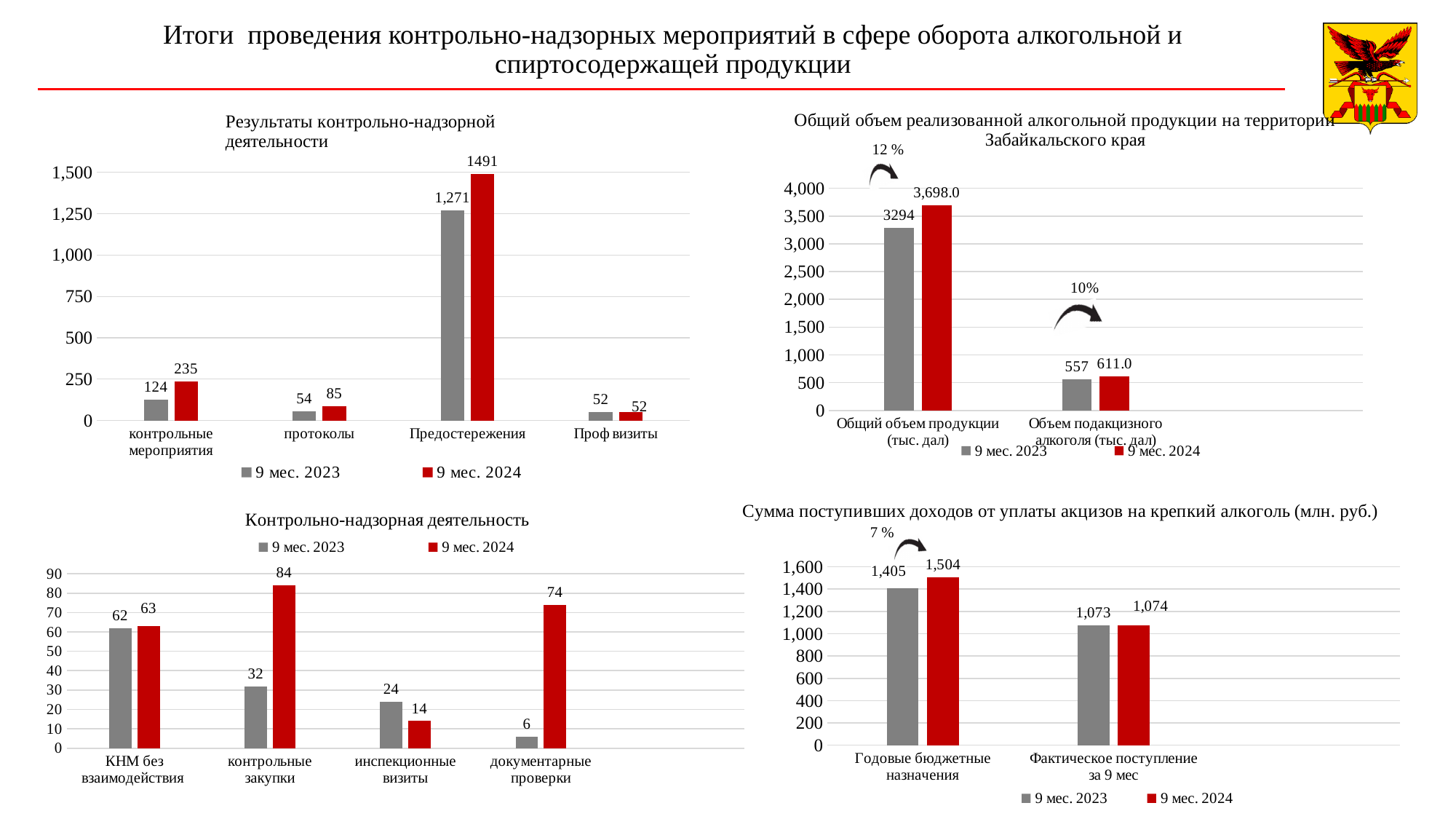
In the chart 'Сумма поступивших доходов от уплаты акцизов на крепкий алкоголь (млн. руб.)', what is the 9 мес. 2024 value for Годовые бюджетные назначения? 1,504 In the chart 'Контрольно-надзорная деятельность', what is the 9 мес. 2024 value for документарные проверки? 74 In the chart 'Контрольно-надзорная деятельность', which category has the lowest value in the 9 мес. 2023 series? документарные проверки In the chart 'Результаты контрольно-надзорной деятельности', what is the value for Предостережения in the 9 мес. 2024 series? 1491 What type of chart is 'Сумма поступивших доходов от уплаты акцизов на крепкий алкоголь (млн. руб.)'? Bar chart In the chart 'Общий объем реализованной алкогольной продукции на территории Забайкальского края', what is the 9 мес. 2024 value for Общий объем продукции (тыс. дал)? 3,698.0 In the chart 'Результаты контрольно-надзорной деятельности', what is the difference between the 9 мес. 2024 and 9 мес. 2023 values for контрольные мероприятия? 111 In the chart 'Общий объем реализованной алкогольной продукции на территории Забайкальского края', how many series does the legend list? 2 In the chart 'Результаты контрольно-надзорной деятельности', how many categories are shown on the x axis? 4 In the chart 'Общий объем реализованной алкогольной продукции на территории Забайкальского края', what is the 9 мес. 2023 value for Объем подакцизного алкоголя (тыс. дал)? 557 In the chart 'Контрольно-надзорная деятельность', which is larger for инспекционные визиты: the 9 мес. 2023 value or the 9 мес. 2024 value? 9 мес. 2023 In the chart 'Результаты контрольно-надзорной деятельности', which category has the highest value in the 9 мес. 2023 series? Предостережения